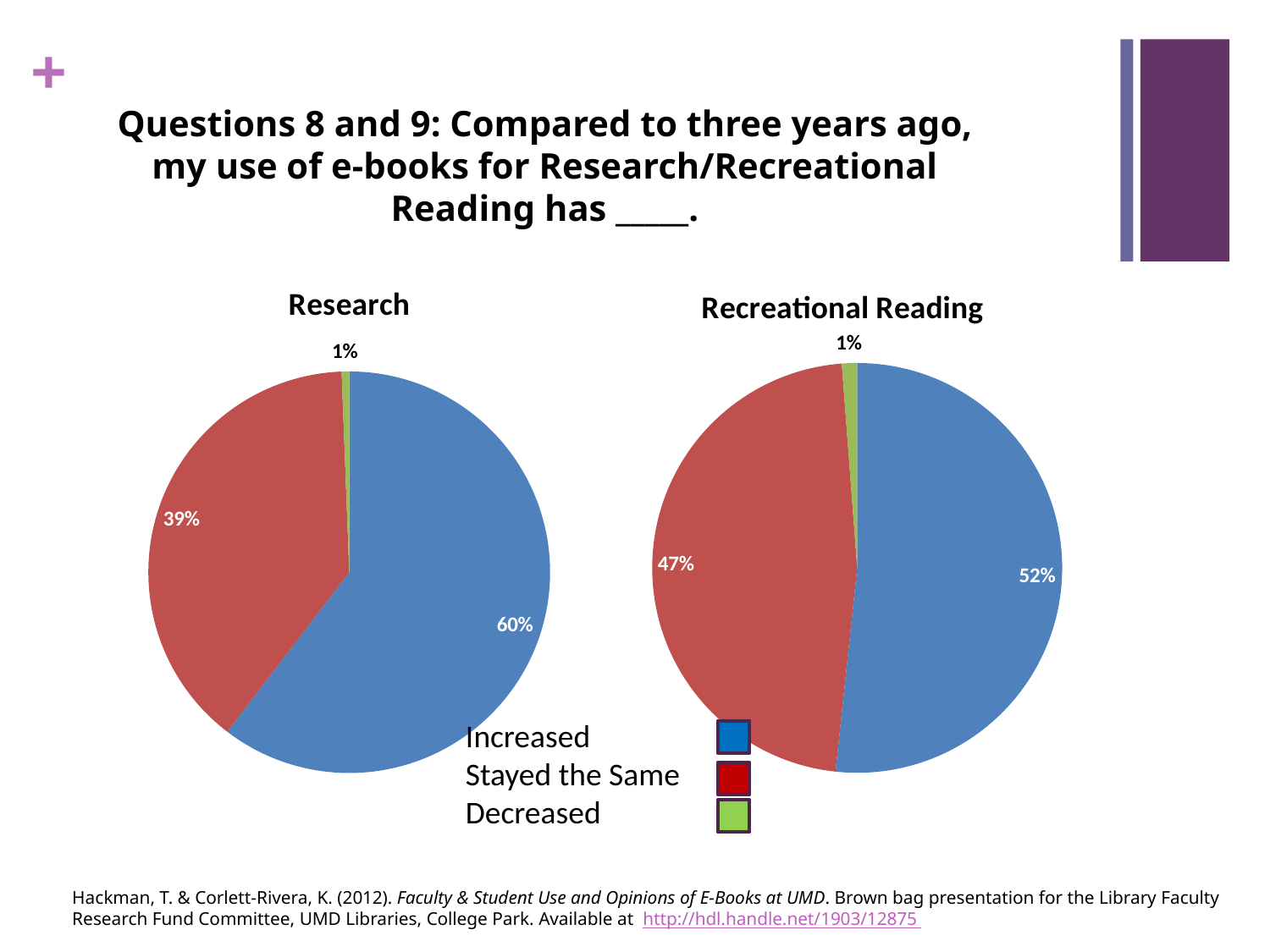
Which chart shows a larger share for Increased, Research or Recreational Reading? Research How many categories does the legend list for the charts? 3 In the Research chart, which response has the smallest share? Decreased What type of chart is used for the Research data? Pie chart In the Research chart, what percentage of respondents said their e-book use has Increased? 60% In the Recreational Reading chart, what is the difference between the Increased and Stayed the Same shares? 5% In the Recreational Reading chart, what percentage said their e-book use Stayed the Same? 47% In the Research chart, what percentage said their e-book use Stayed the Same? 39% In the Research chart, what is the difference between the Increased and Stayed the Same shares? 21% In the Recreational Reading chart, what percentage said their e-book use has Increased? 52% In the Recreational Reading chart, what percentage said their e-book use has Decreased? 1% In the Research chart, which response has the largest share? Increased